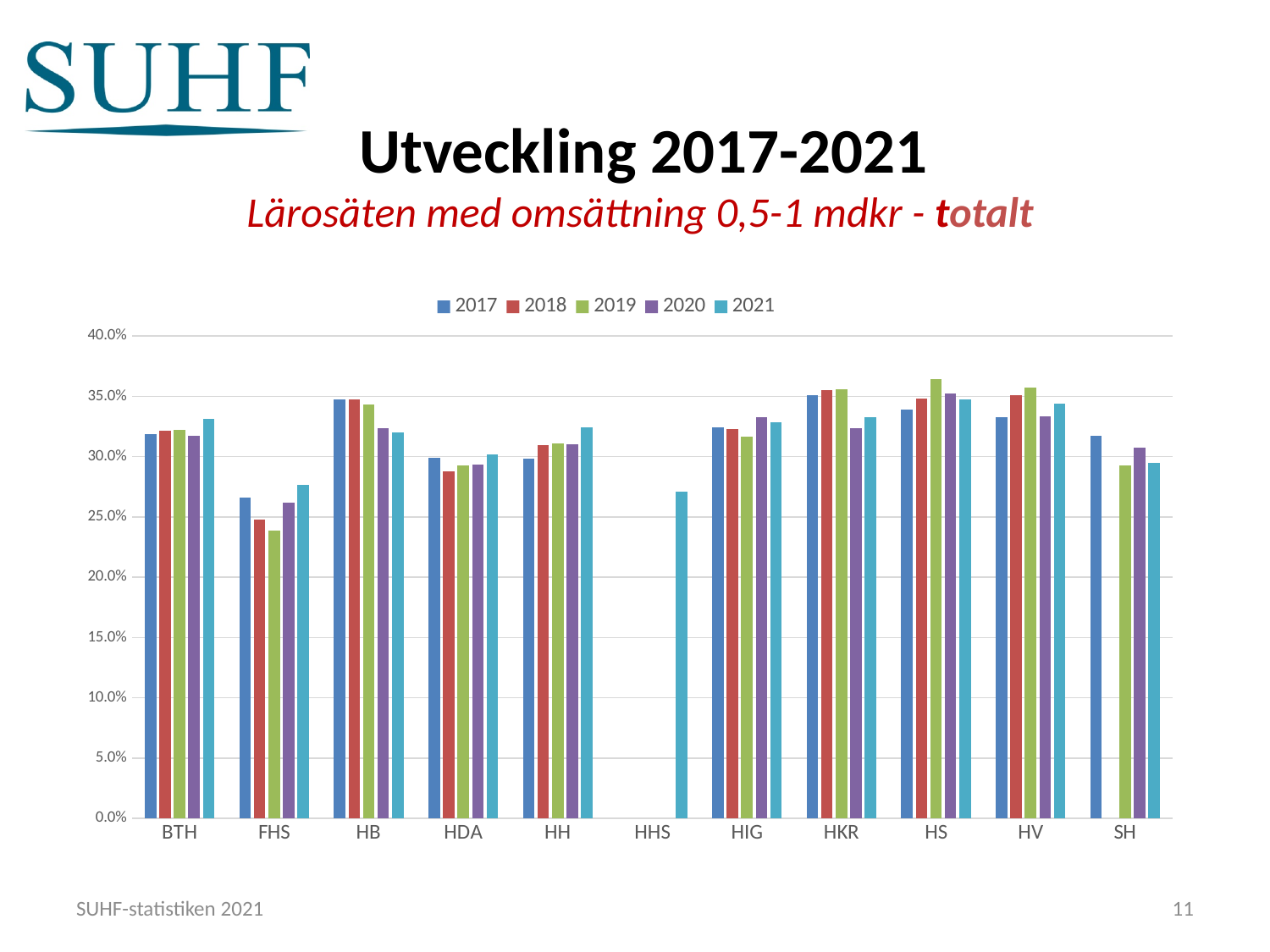
Which category has the lowest values overall in the chart? FHS Is the value for FHS in 2019 greater or less than 25%? less Is the value for HHS in 2021 greater or less than 25%? greater Is the value for BTH in 2017 greater or less than 30%? greater What kind of chart is shown on the slide? bar chart Which years are listed in the legend? 2017, 2018, 2019, 2020, 2021 For FHS, which year has the lowest value? 2019 Which is larger for FHS: the 2017 value or the 2019 value? 2017 How many series does the legend list? 5 How many categories (lärosäten) are shown on the x axis? 11